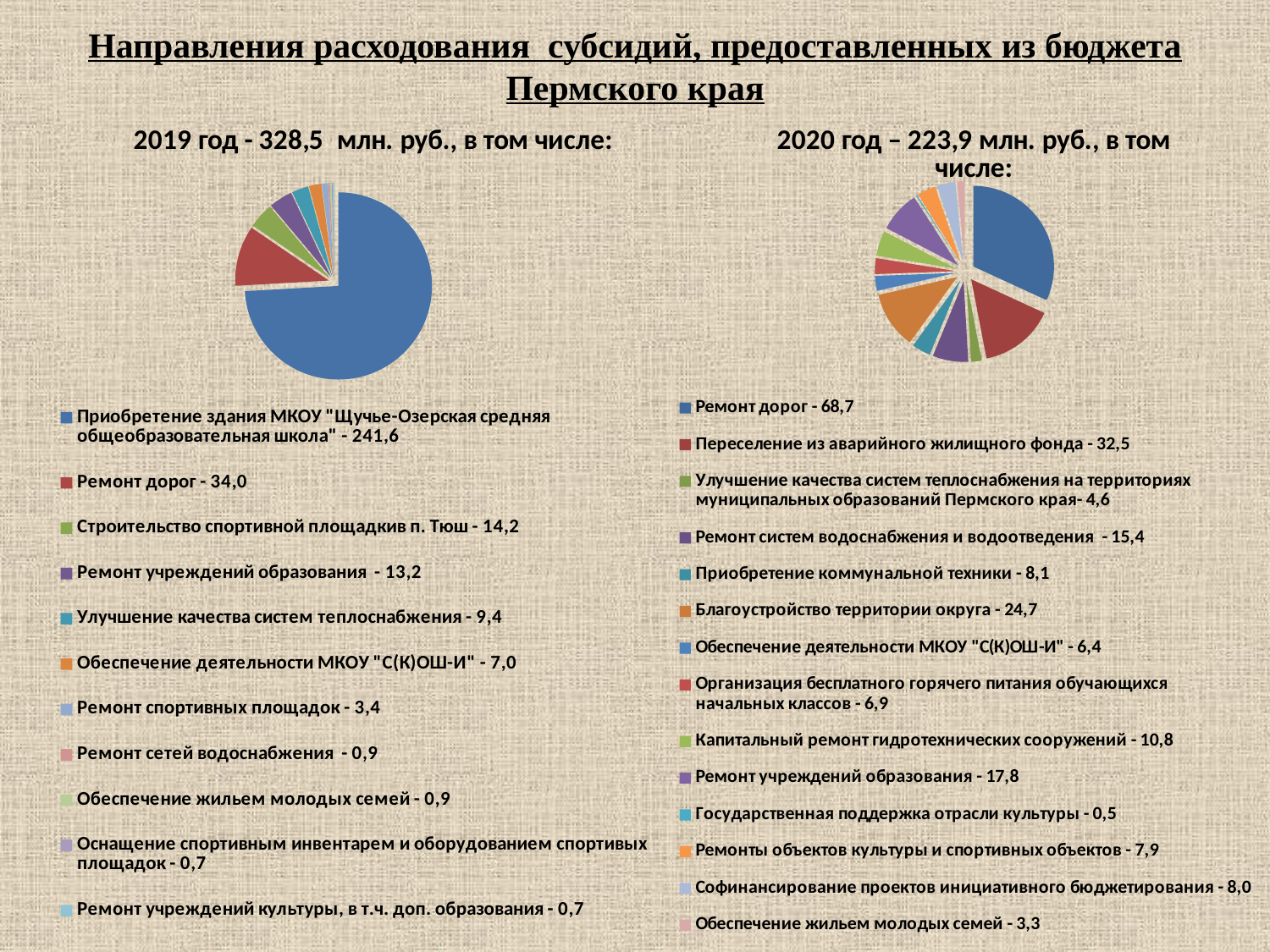
What total amount in million rubles is given for 2020 in the heading of the right chart? 223,9 млн. руб. In the 2020 chart, which is larger: "Ремонт учреждений образования" or "Ремонт систем водоснабжения и водоотведения"? Ремонт учреждений образования In the 2020 chart, what is the value for "Благоустройство территории округа"? 24,7 In the 2019 chart, what is the difference between "Ремонт дорог" and "Строительство спортивной площадки в п. Тюш"? 19,8 In the 2020 chart, how many categories does the legend list? 14 In the 2020 chart, what is the difference between "Ремонт дорог" and "Переселение из аварийного жилищного фонда"? 36,2 In the 2019 chart, which category has the largest value? Приобретение здания МКОУ "Щучье-Озерская средняя общеобразовательная школа" In the 2019 chart, how many categories does the legend list? 11 In the 2019 chart, what is the value for "Ремонт дорог"? 34,0 In the 2020 chart, which category has the smallest value? Государственная поддержка отрасли культуры In the 2020 chart, which category has the largest value? Ремонт дорог What kind of chart is used on the left side of the slide for 2019? pie chart